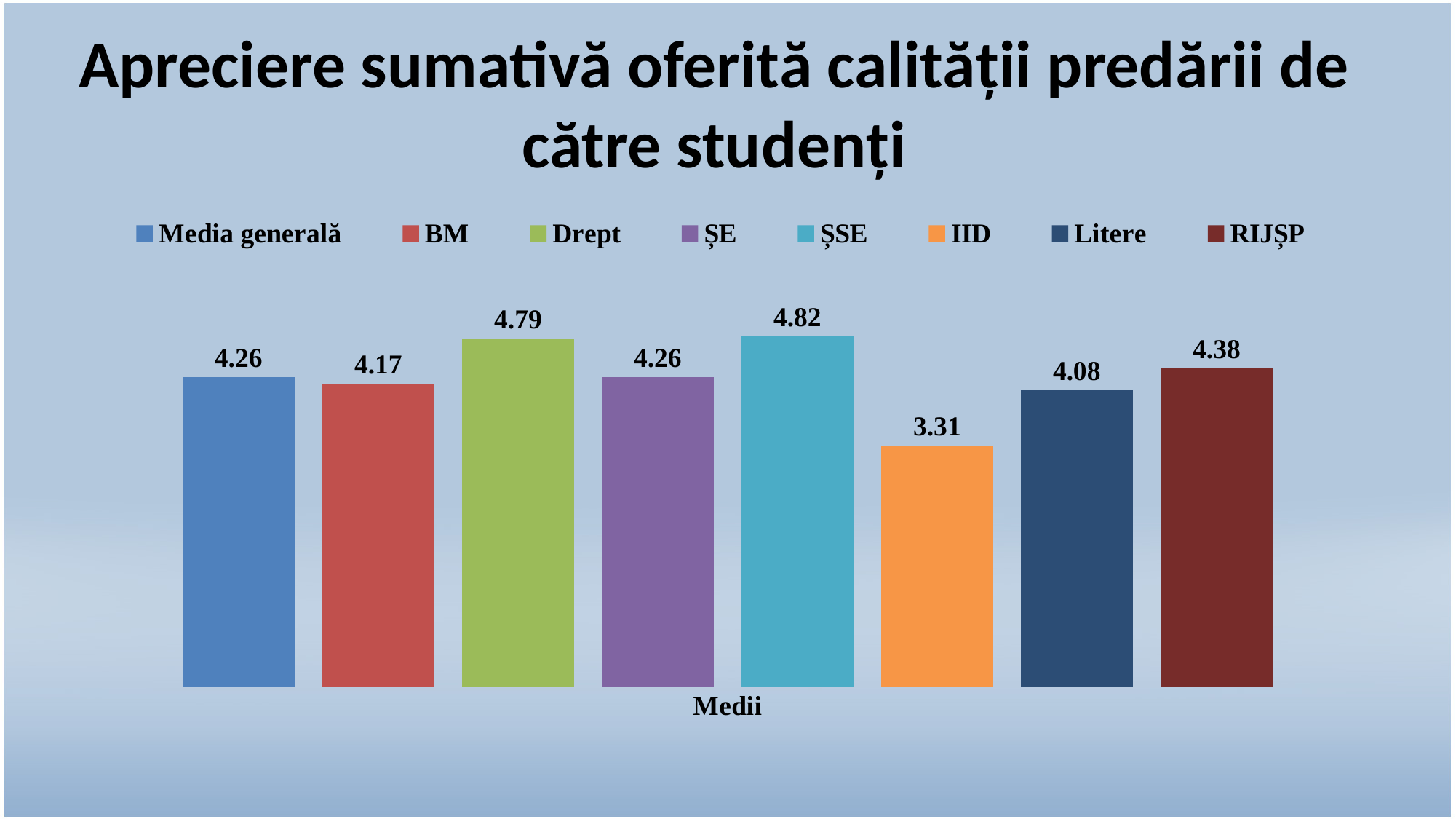
Which series has the highest value? ȘSE What is the value for Media generală? 4.26 Which series has the lowest value? IID What is the label shown on the x axis? Medii What is the value for Drept? 4.79 Which is larger, the value for Litere or the value for RIJȘP? RIJȘP What kind of chart is shown on the slide? Bar chart What is the difference between the values for ȘSE and IID? 1.51 How many series does the legend list? 8 What is the value for RIJȘP? 4.38 What is the difference between the values for Drept and BM? 0.62 What is the value for IID? 3.31